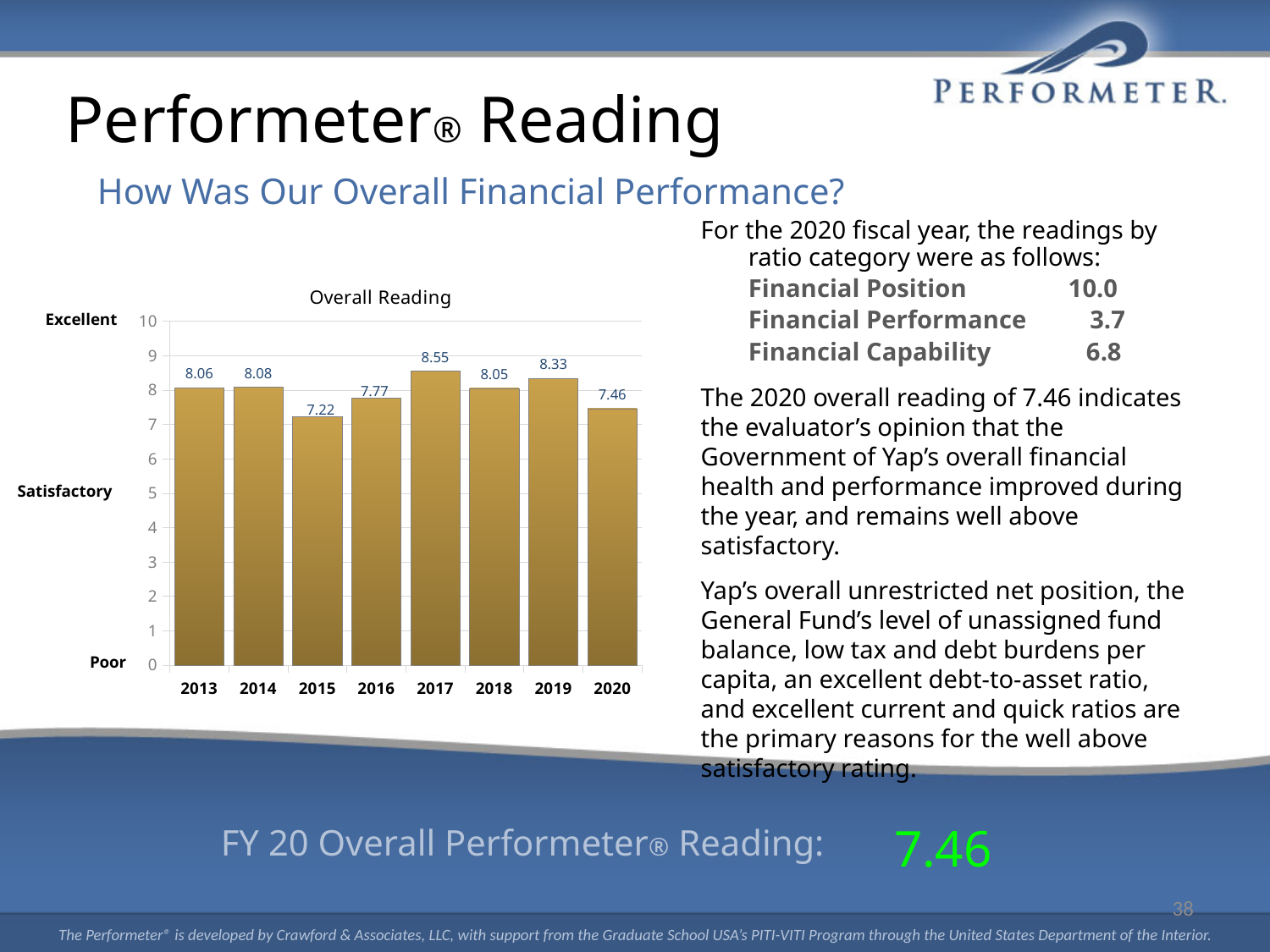
What is the overall reading for 2020? 7.46 What is the overall reading for 2017? 8.55 What is the difference between the overall readings for 2019 and 2020? 0.87 How many years are shown on the x axis of the chart? 8 Which year has the highest overall reading? 2017 What kind of chart is shown on the slide? bar chart Is the value for 2018 greater or less than 5? greater Which year has the lowest overall reading? 2015 Did the overall reading rise or fall from 2019 to 2020? fall Which year has a higher overall reading, 2016 or 2019? 2019 What is the overall reading for 2015? 7.22 What is the title of the chart? Overall Reading